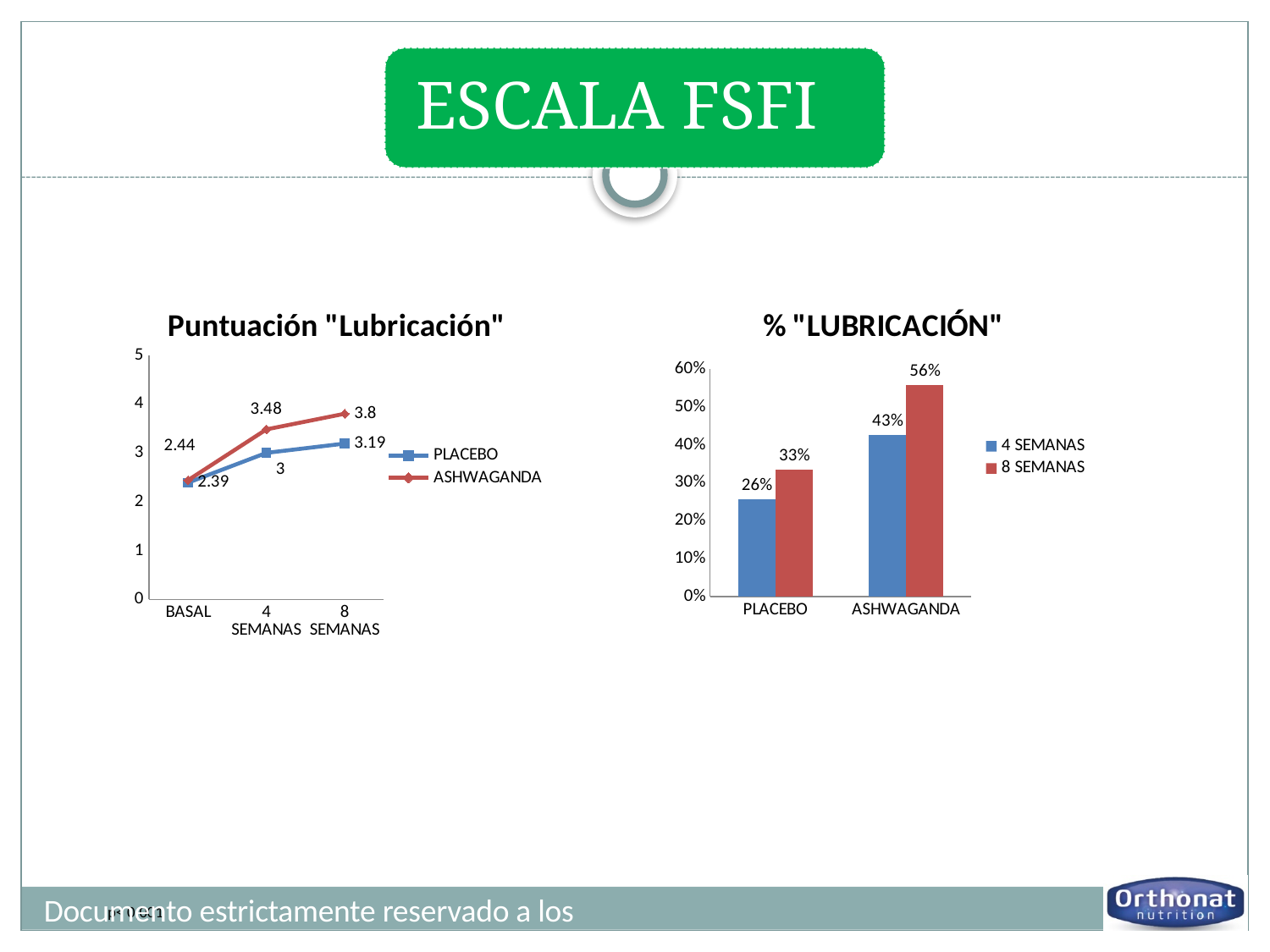
In the "Puntuación "Lubricación"" chart, do the PLACEBO values rise or fall from BASAL to 8 SEMANAS? rise In the "Puntuación "Lubricación"" chart, what is the value for ASHWAGANDA at 8 SEMANAS? 3.8 In the "% "LUBRICACIÓN"" chart, what is the value for ASHWAGANDA at 8 SEMANAS? 56% What kind of chart is the "Puntuación "Lubricación"" chart? line chart In the "Puntuación "Lubricación"" chart, which series is higher at 4 SEMANAS, PLACEBO or ASHWAGANDA? ASHWAGANDA In the "Puntuación "Lubricación"" chart, what is the difference between ASHWAGANDA and PLACEBO at 8 SEMANAS? 0.61 In the "% "LUBRICACIÓN"" chart, what is the difference between the 8 SEMANAS values for ASHWAGANDA and PLACEBO? 23% In the "% "LUBRICACIÓN"" chart, what is the value for PLACEBO at 4 SEMANAS? 26% What kind of chart is the "% "LUBRICACIÓN"" chart? bar chart In the "% "LUBRICACIÓN"" chart, which bar is the lowest? PLACEBO, 4 SEMANAS How many series does the legend of the "% "LUBRICACIÓN"" chart list? 2 In the "Puntuación "Lubricación"" chart, what is the value for PLACEBO at 4 SEMANAS? 3